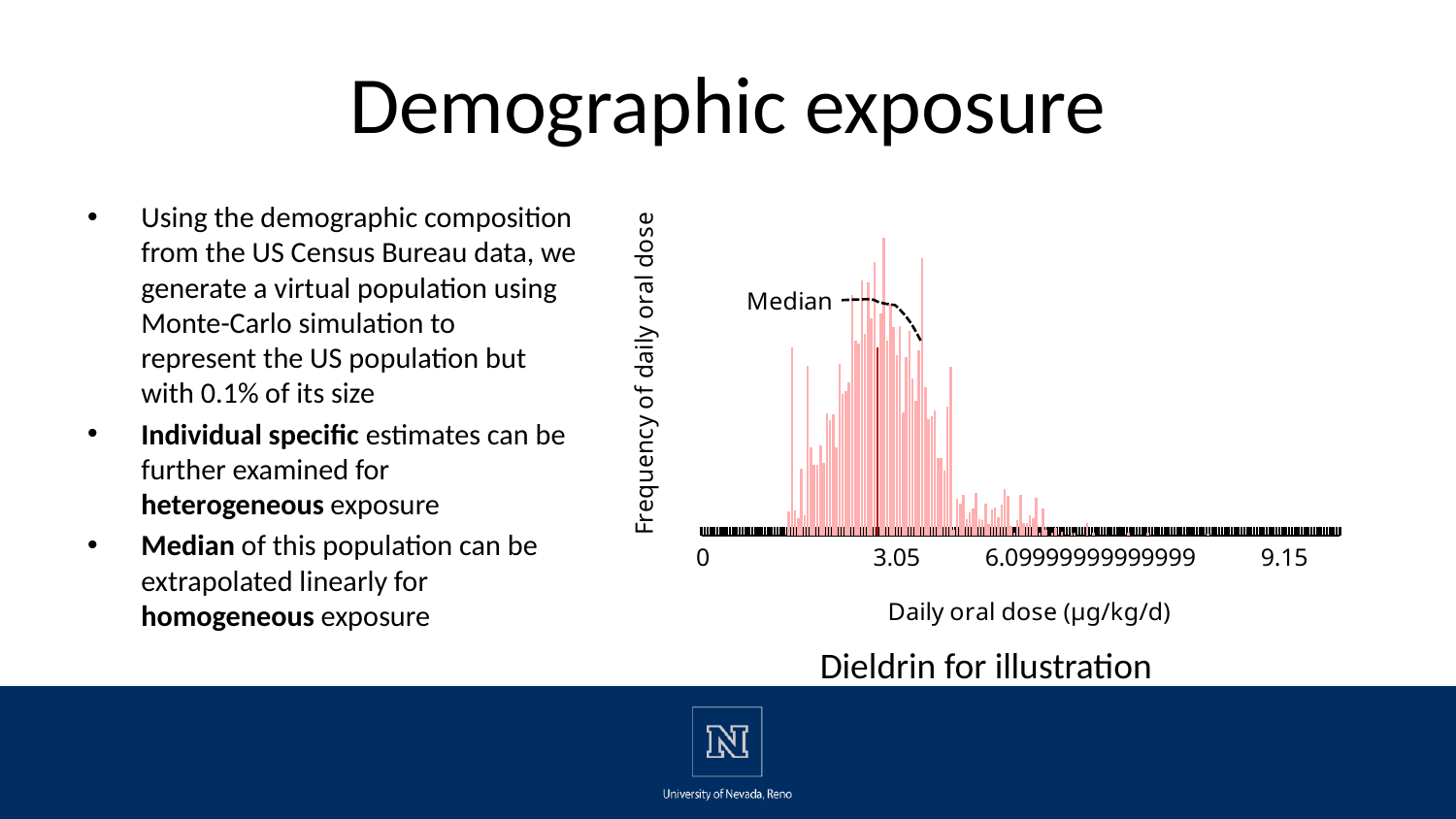
What is the label of the x axis of the chart? Daily oral dose (µg/kg/d) What is the label of the y axis of the chart? Frequency of daily oral dose What kind of chart is shown on the slide? bar chart What is the largest value labeled on the x axis of the chart? 9.15 Are there more bars in the chart between 0 and 3.05 or between 6.09999999999999 and 9.15 on the x axis? between 0 and 3.05 Is the median daily oral dose marked on the chart greater or less than 3.05? less How many labeled tick values are shown on the x axis of the chart? 4 Is the median daily oral dose marked on the chart greater or less than 6.09999999999999? less